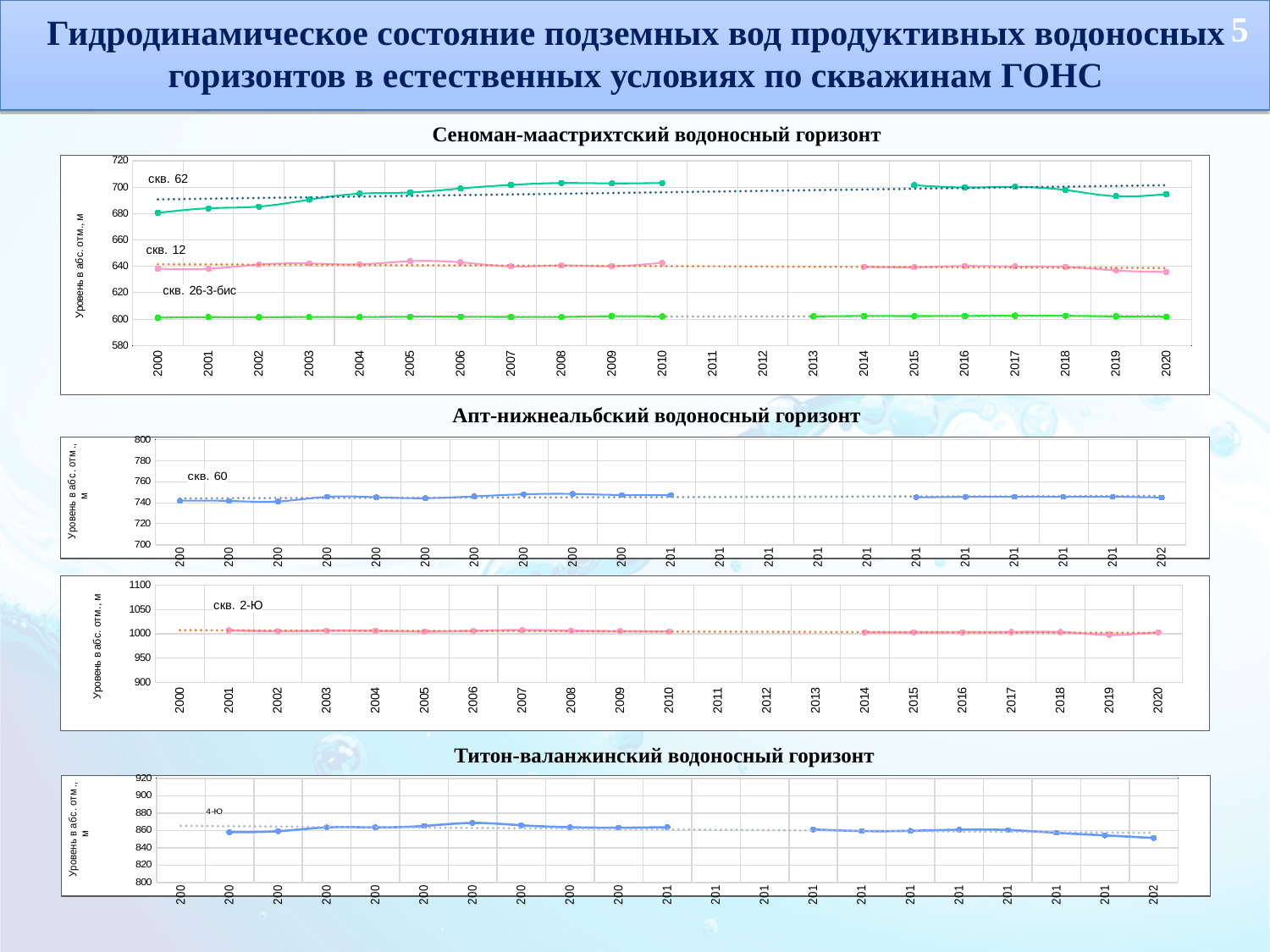
What is the y-axis label of the Сеноман-маастрихтский chart? Уровень в абс. отм., м What type of chart is used for the Сеноман-маастрихтский водоносный горизонт? line chart In the Апт-нижнеальбский chart for скв. 2-Ю, is the value in 2010 greater or less than 1050? less In the Сеноман-маастрихтский chart, does the level for скв. 62 rise or fall from 2000 to 2010? rise In the Сеноман-маастрихтский chart, which well has the highest water level? скв. 62 In the Сеноман-маастрихтский chart, is the value for скв. 26-3-бис in 2010 greater or less than 620? less In the Сеноман-маастрихтский chart, is the value for скв. 62 in 2000 greater or less than 700? less In the Титон-валанжинский chart, does the level for 4-Ю rise or fall from 2016 to 2020? fall In the Сеноман-маастрихтский chart, how many wells (series) are plotted? 3 In the Сеноман-маастрихтский chart, which well has the lowest water level? скв. 26-3-бис